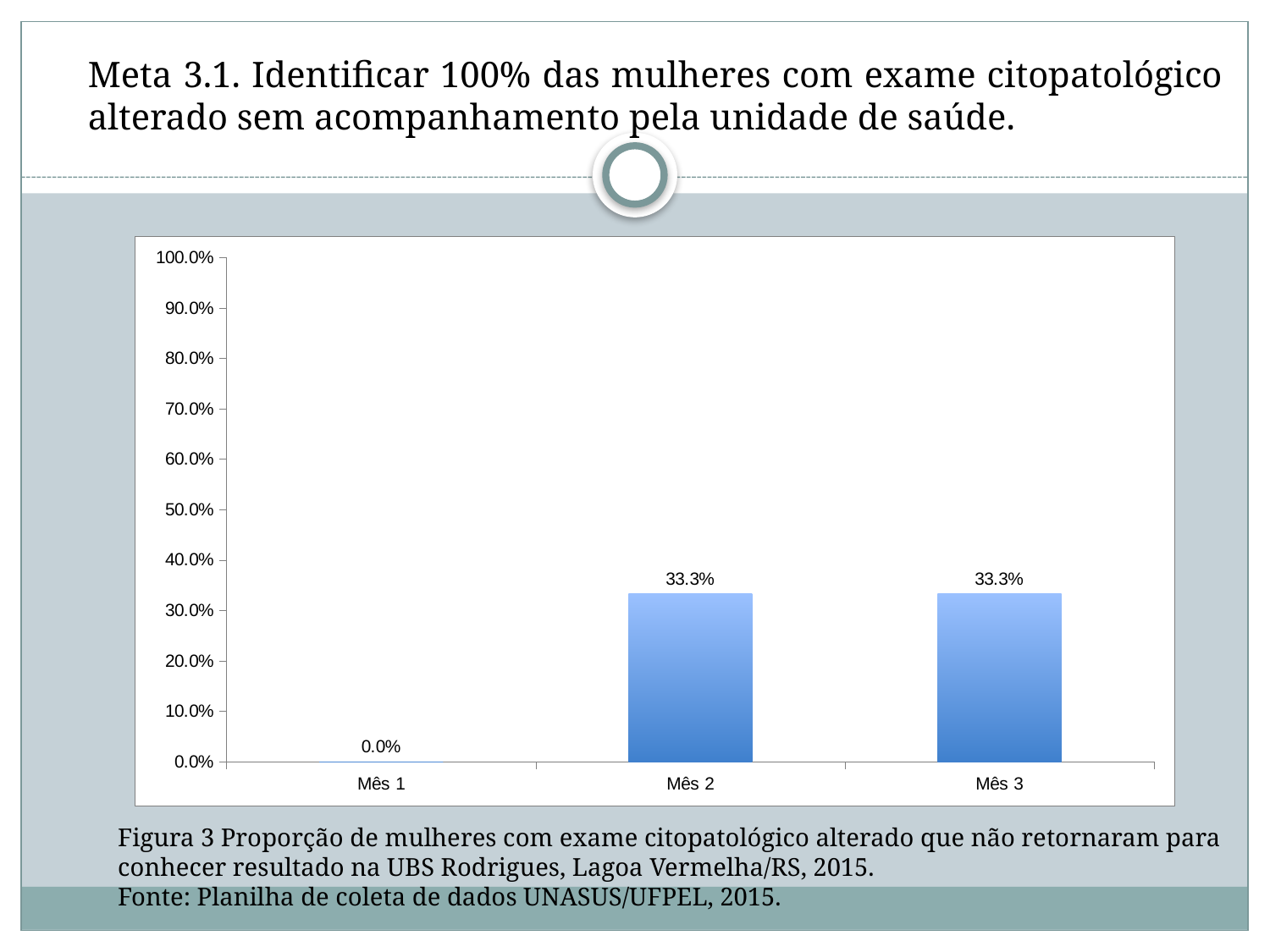
What is the source cited below the chart? Planilha de coleta de dados UNASUS/UFPEL, 2015 What is the value for Mês 2? 33.3% How many months are shown on the x axis? 3 Is the value for Mês 2 greater or less than 50.0%? less What kind of chart is shown on the slide? bar chart Which month has the lowest value? Mês 1 What is the value for Mês 3? 33.3% What is the value for Mês 1? 0.0% Which is larger, the value for Mês 1 or the value for Mês 3? Mês 3 Do the values rise or fall from Mês 1 to Mês 2? rise What is the difference between the values for Mês 2 and Mês 1? 33.3% What is the highest value shown on the y axis? 100.0%